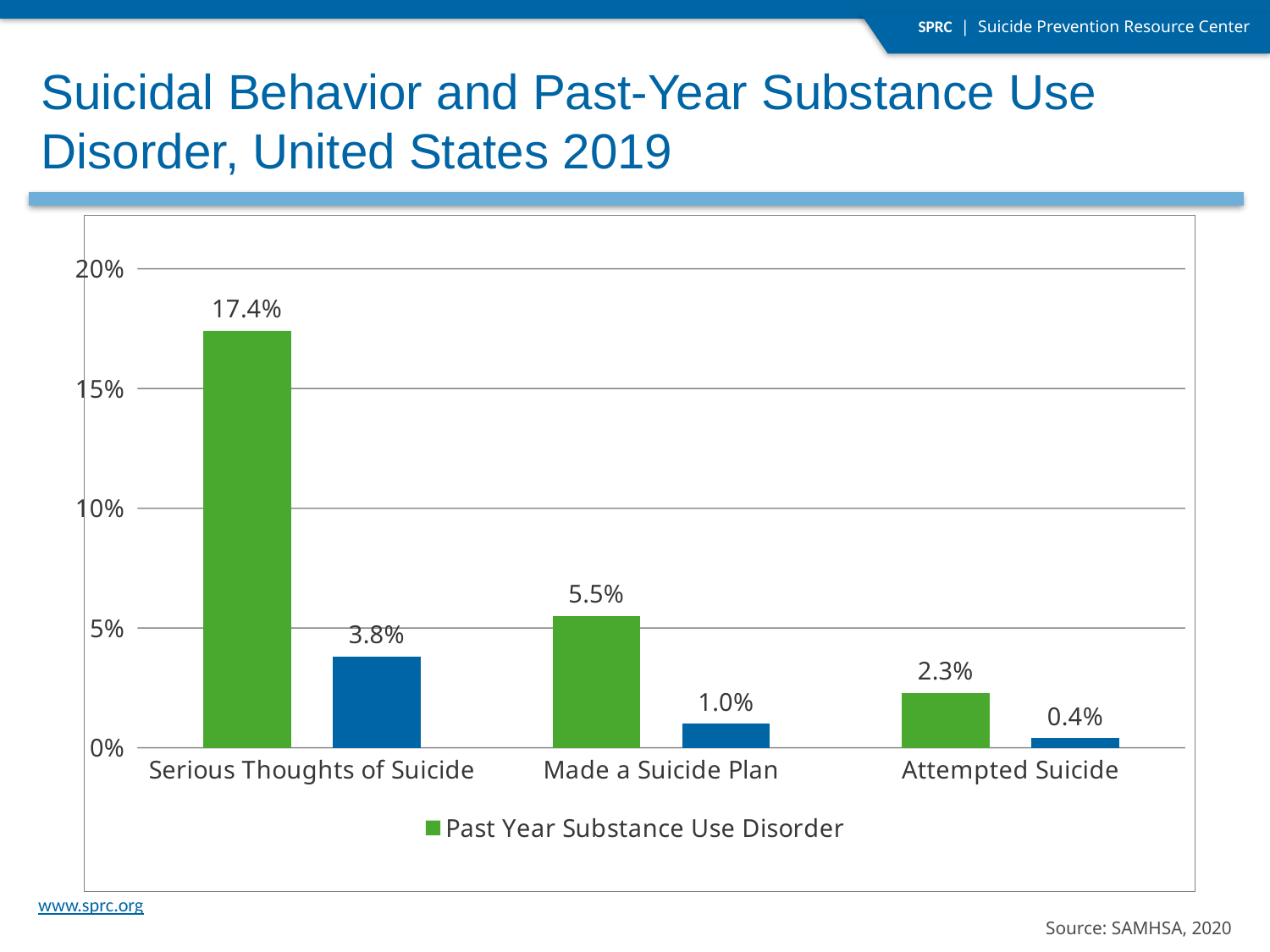
What is the difference between the Past Year Substance Use Disorder values for Serious Thoughts of Suicide and Made a Suicide Plan? 11.9% How many series does the legend list? 1 What value is shown on the blue bar for Serious Thoughts of Suicide? 3.8% What value is shown on the blue bar for Attempted Suicide? 0.4% Which is larger: the Past Year Substance Use Disorder value for Made a Suicide Plan or for Attempted Suicide? Made a Suicide Plan What is the Past Year Substance Use Disorder value for Attempted Suicide? 2.3% Which category has the highest Past Year Substance Use Disorder value? Serious Thoughts of Suicide Which category has the lowest Past Year Substance Use Disorder value? Attempted Suicide How many categories are shown on the x axis? 3 What kind of chart is shown on the slide? Bar chart What is the Past Year Substance Use Disorder value for Made a Suicide Plan? 5.5% What is the Past Year Substance Use Disorder value for Serious Thoughts of Suicide? 17.4%